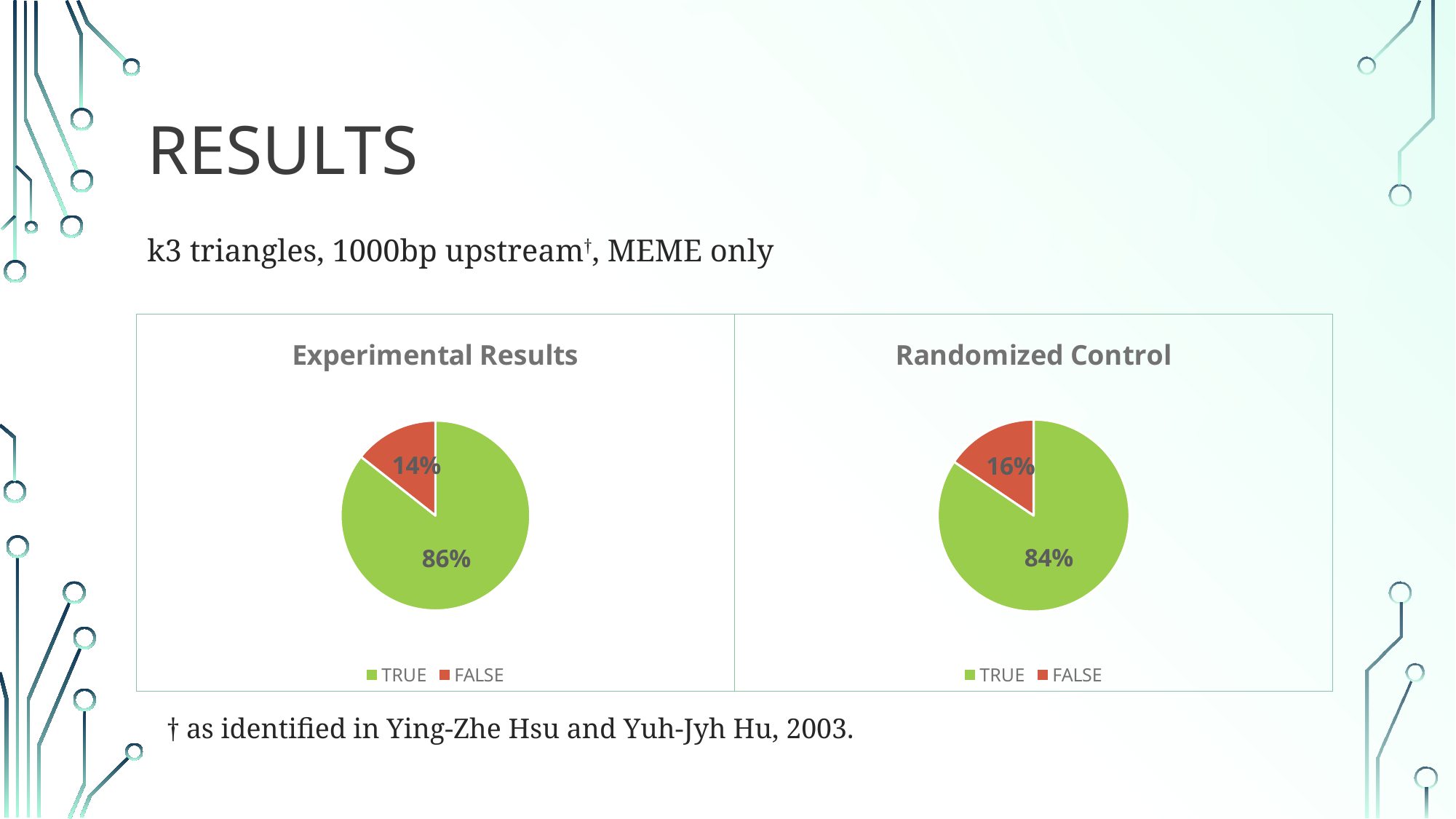
What is the difference between the FALSE share in the Randomized Control chart and the FALSE share in the Experimental Results chart? 2% In the Experimental Results chart, which slice is the largest? TRUE How many slices does the Randomized Control pie chart have? 2 In the Randomized Control chart, what colour is the FALSE slice? Red In the Experimental Results chart, what share of the pie is FALSE? 14% In the Experimental Results chart, what share of the pie is TRUE? 86% What kind of chart is the Experimental Results chart? Pie chart In the Randomized Control chart, what share of the pie is TRUE? 84% Which is larger: the TRUE share in the Experimental Results chart or the TRUE share in the Randomized Control chart? Experimental Results How many entries does the legend of the Experimental Results chart list? 2 In the Randomized Control chart, which slice is the smallest? FALSE